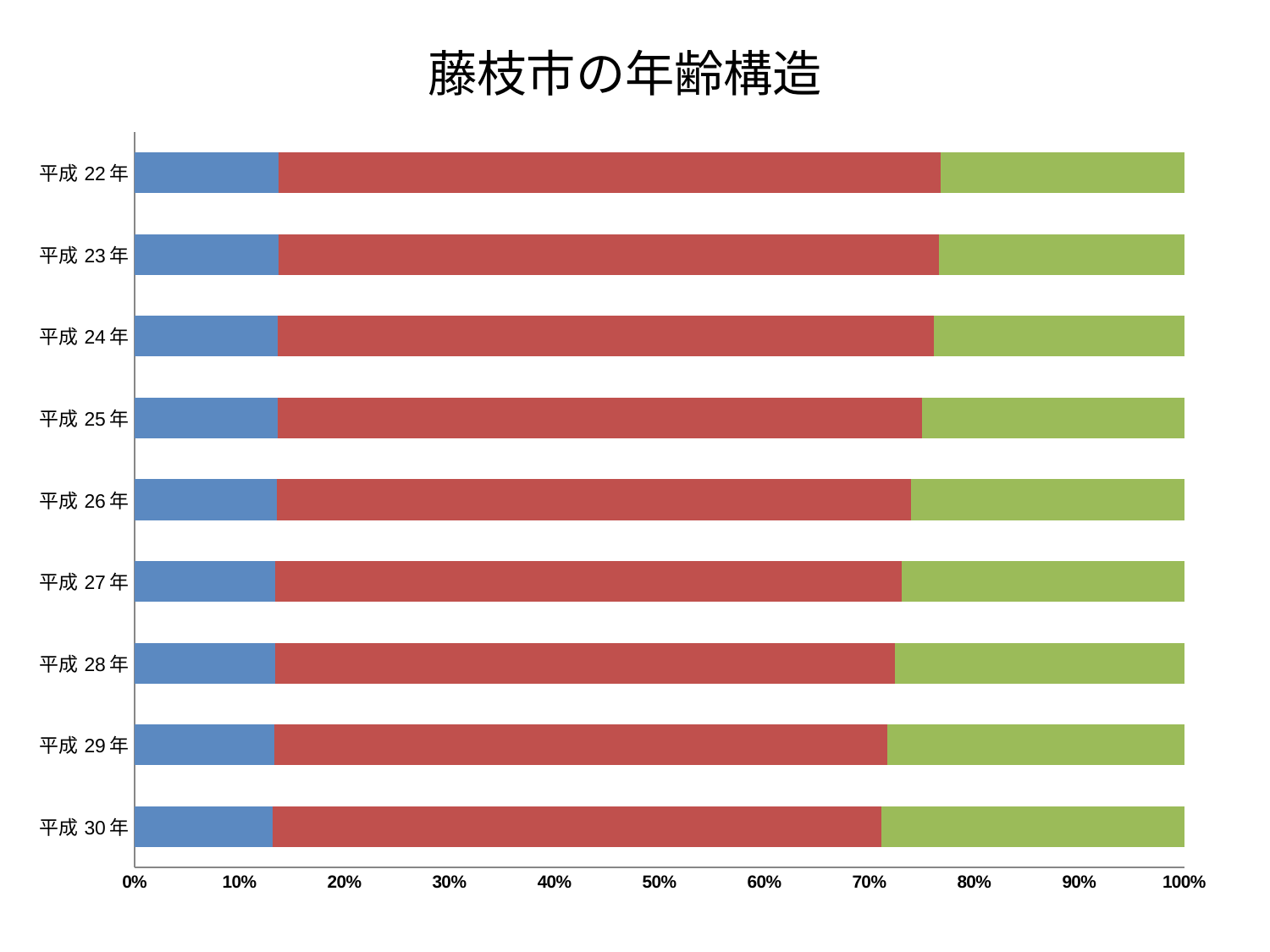
Is the green segment for 平成30年 greater or less than 20%? greater Is the red segment for 平成30年 greater or less than 50%? greater What colour is the first (leftmost) segment of each bar? blue Does the red segment grow or shrink from 平成22年 to 平成30年? shrink Does the green segment grow or shrink from 平成22年 to 平成30年? grow What kind of chart is shown on the slide? stacked bar chart Which is larger, the green segment for 平成22年 or the green segment for 平成30年? 平成30年 Which is larger, the red segment for 平成22年 or the red segment for 平成30年? 平成22年 What is the total of the stacked bar for 平成30年? 100% Is the blue segment for 平成22年 greater or less than 20%? less How many years (categories) are shown on the vertical axis? 9 What is the title of the chart? 藤枝市の年齢構造